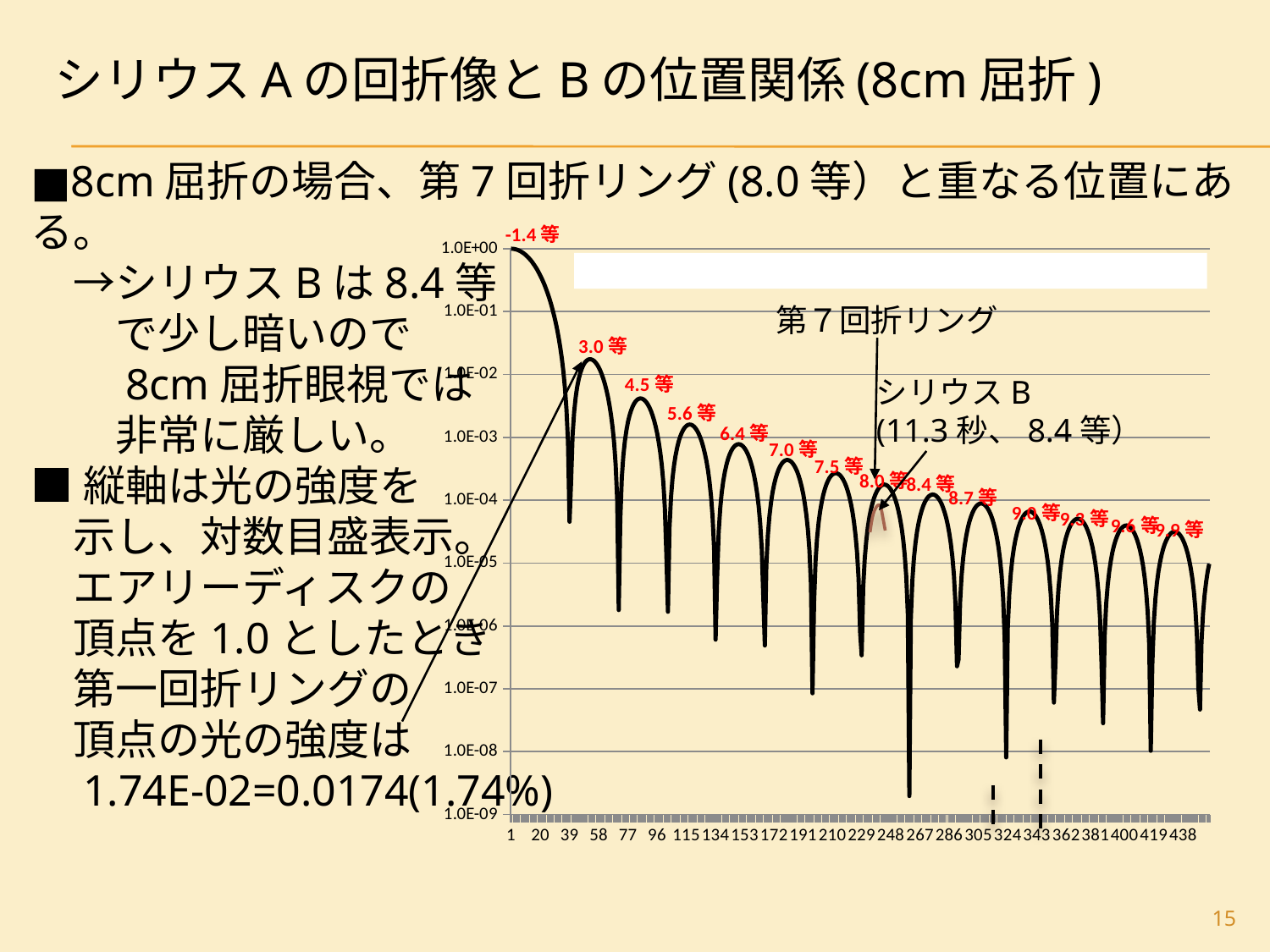
Which is higher in intensity, the peak labeled 3.0等 or the peak labeled 7.0等? 3.0等 Is the peak labeled 4.5等 greater or less than 1.0E-02? less Which labeled peak has the highest intensity in the chart? -1.4等 What kind of chart is shown on the slide? line chart Which labeled peak has the lowest intensity in the chart? 9.9等 Is the vertical axis of the chart on a linear or logarithmic scale? logarithmic How many red magnitude labels (等) are placed on the peaks of the chart? 14 What is the last tick label on the horizontal axis of the chart? 438 Do the peak intensities rise or fall moving from left to right along the horizontal axis? fall What is the lowest tick value on the vertical axis of the chart? 1.0E-09 Is the peak labeled 6.4等 greater or less than 1.0E-03? less What is the topmost tick value on the vertical axis of the chart? 1.0E+00